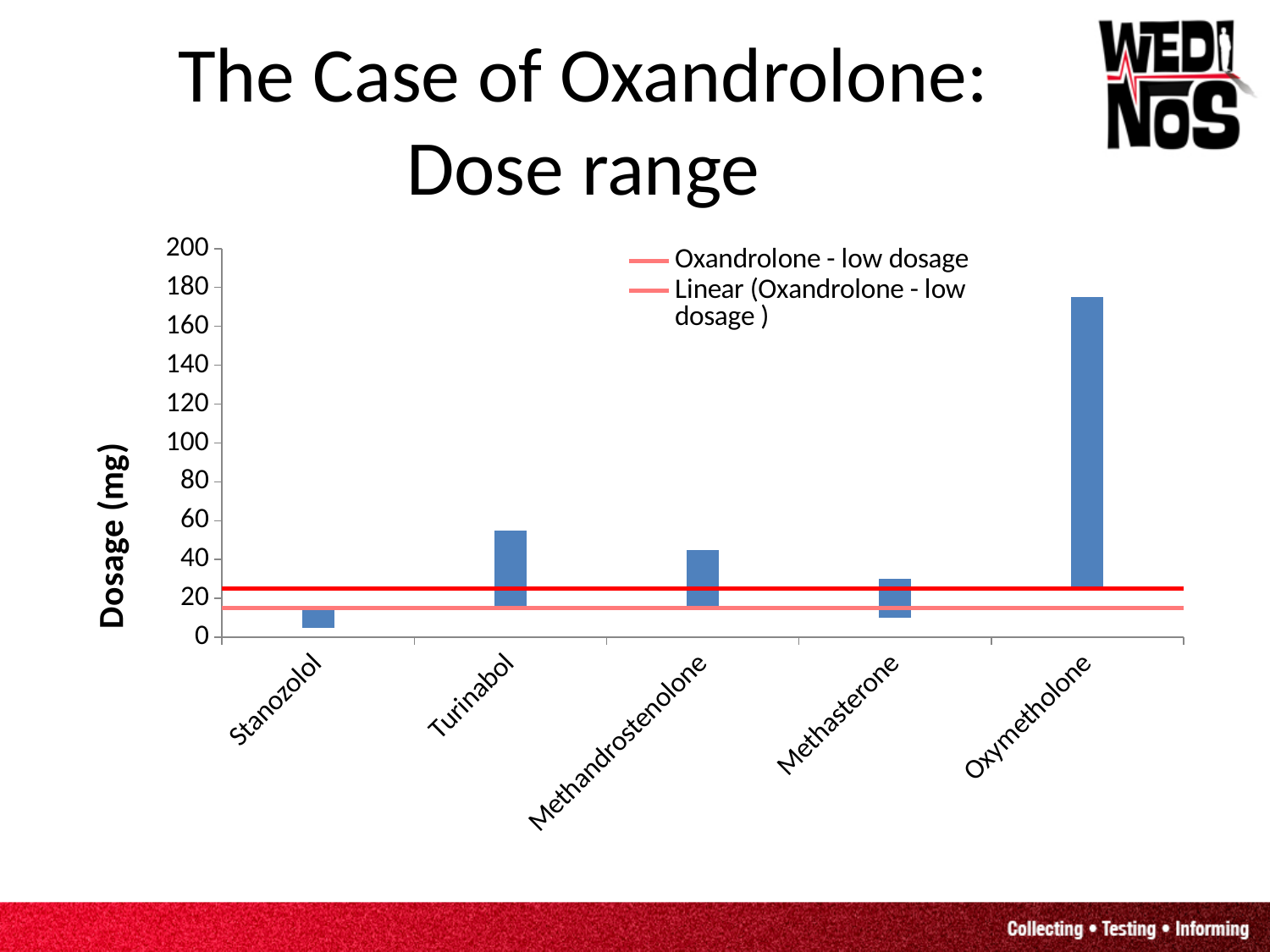
Is the top of the dosage bar for Methasterone greater or less than 40? less How many substances are shown along the x axis of the chart? 5 Is the top of the dosage bar for Stanozolol greater or less than 20? less What kind of chart is shown on the slide? bar chart Which reaches a higher dosage, the bar for Turinabol or the bar for Methandrostenolone? Turinabol Which substance has the highest dosage bar in the chart? Oxymetholone What is the label on the vertical axis of the chart? Dosage (mg) How many entries does the chart legend list? 2 Which substance has the lowest dosage bar in the chart? Stanozolol Which reaches a higher dosage, the bar for Oxymetholone or the bar for Methasterone? Oxymetholone Is the top of the dosage bar for Turinabol greater or less than 80? less